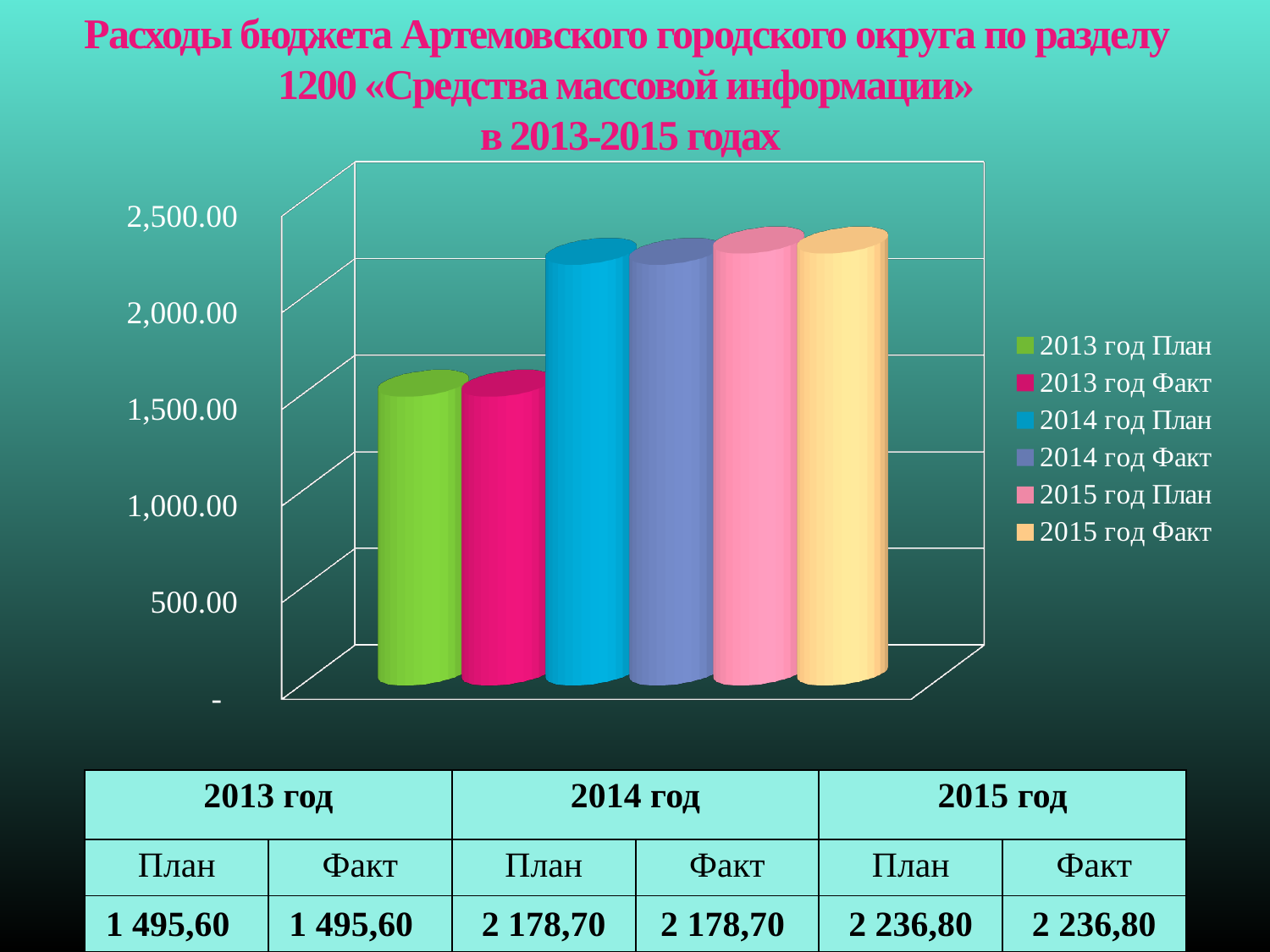
What is the difference between the 2014 год План value and the 2013 год План value? 683,10 Do the values rise or fall from 2013 to 2015? rise What is the value for 2013 год План? 1 495,60 Which is larger, the value for 2013 год Факт or the value for 2014 год Факт? 2014 год Факт What kind of chart is shown on the slide? bar chart How many series does the legend list? 6 What is the value for 2015 год План? 2 236,80 What is the value for 2014 год Факт? 2 178,70 Which year has the highest values in the chart? 2015 год Which year has the lowest values in the chart? 2013 год Is the value for 2013 год План greater or less than 2,000.00? less What is the difference between the 2015 год Факт value and the 2014 год Факт value? 58,10